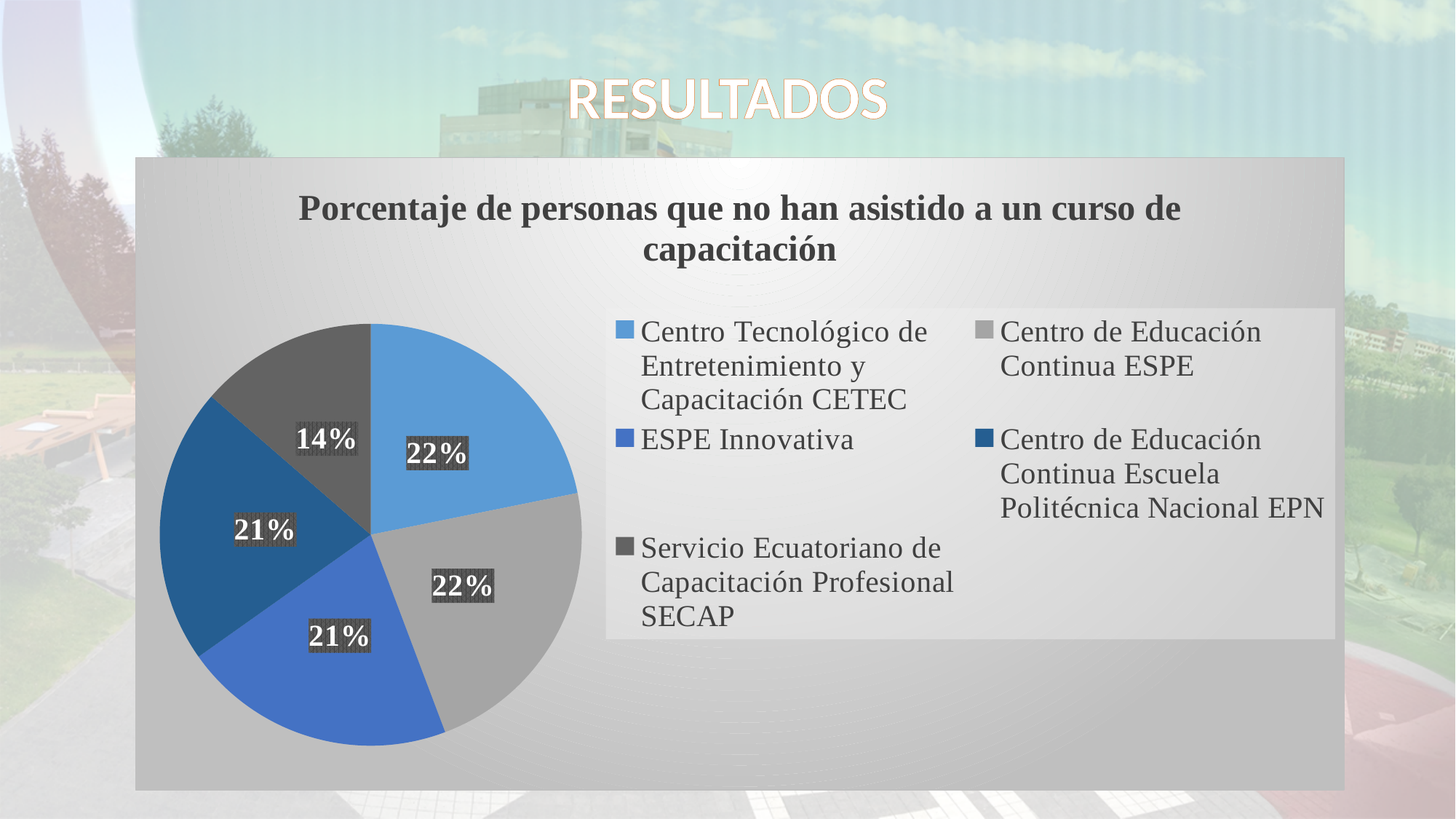
What type of chart is shown on the slide? pie chart Which is larger, the share for CETEC or the share for SECAP? CETEC What percentage is shown for ESPE Innovativa? 21% Which colour represents Servicio Ecuatoriano de Capacitación Profesional SECAP in the legend? dark gray What is the title of the chart? Porcentaje de personas que no han asistido a un curso de capacitación How many slices does the pie chart have? 5 What percentage is shown for Centro Tecnológico de Entretenimiento y Capacitación CETEC? 22% What percentage is shown for Centro de Educación Continua ESPE? 22% What percentage is shown for Servicio Ecuatoriano de Capacitación Profesional SECAP? 14% Which category has the smallest share of the pie? Servicio Ecuatoriano de Capacitación Profesional SECAP What is the difference in percentage points between the share for Centro de Educación Continua ESPE and the share for SECAP? 8 What percentage is shown for Centro de Educación Continua Escuela Politécnica Nacional EPN? 21%